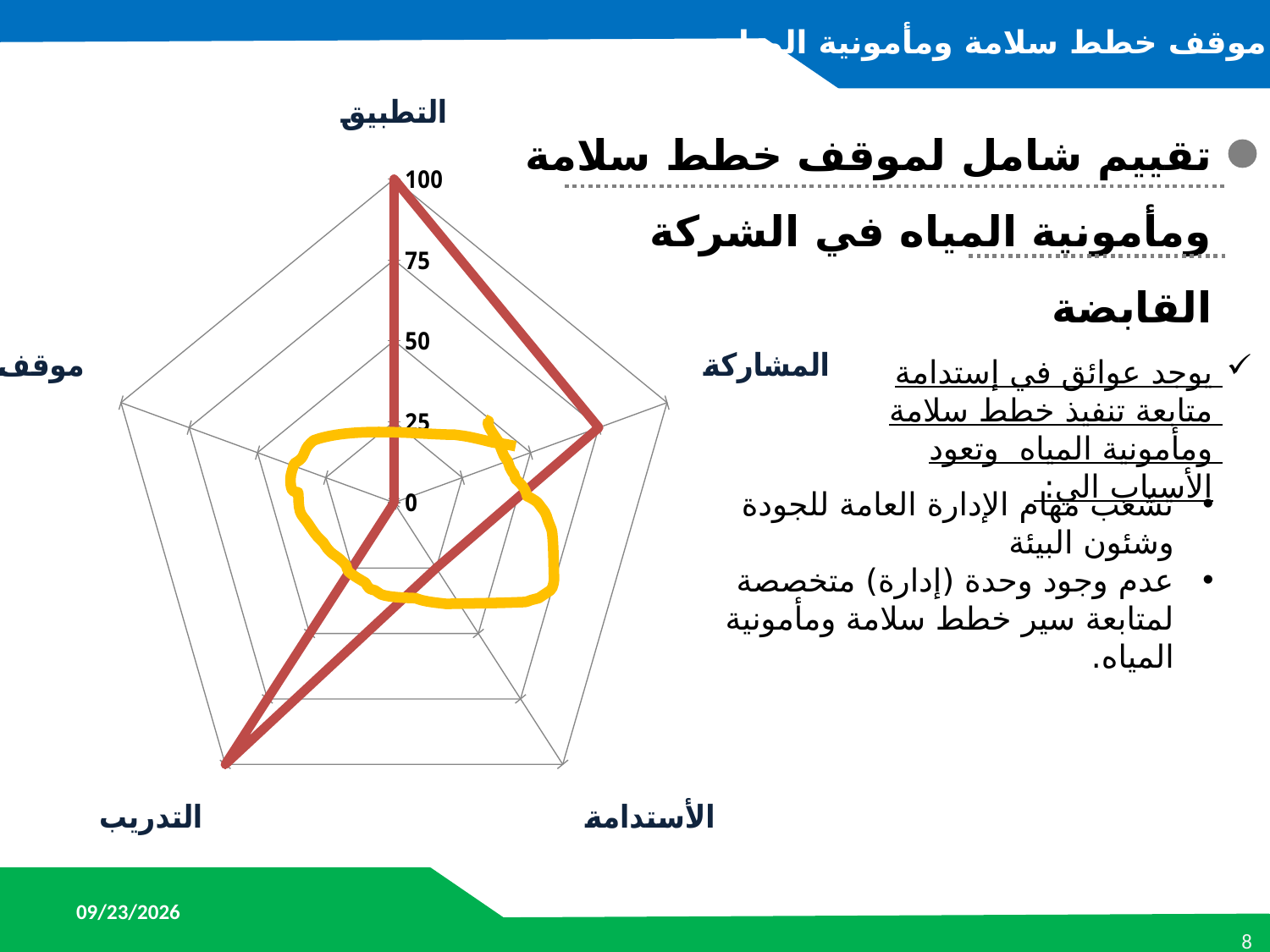
What tick values are printed along the radar chart's axis? 0, 25, 50, 75, 100 How many axes (categories) does the radar chart have? 5 Which has the larger value, المشاركة or الأستدامة? المشاركة What is the highest tick value shown on the radar chart's axis? 100 Is the value for الأستدامة greater or less than 50? less Which category is labelled at the top of the radar chart? التطبيق Is the value for المشاركة greater or less than 50? greater Which has the larger value, التدريب or المشاركة? التدريب What is the value for التدريب on the radar chart? 100 What is the value for التطبيق on the radar chart? 100 What kind of chart is shown on the slide? radar chart Which has the larger value, التطبيق or الأستدامة? التطبيق